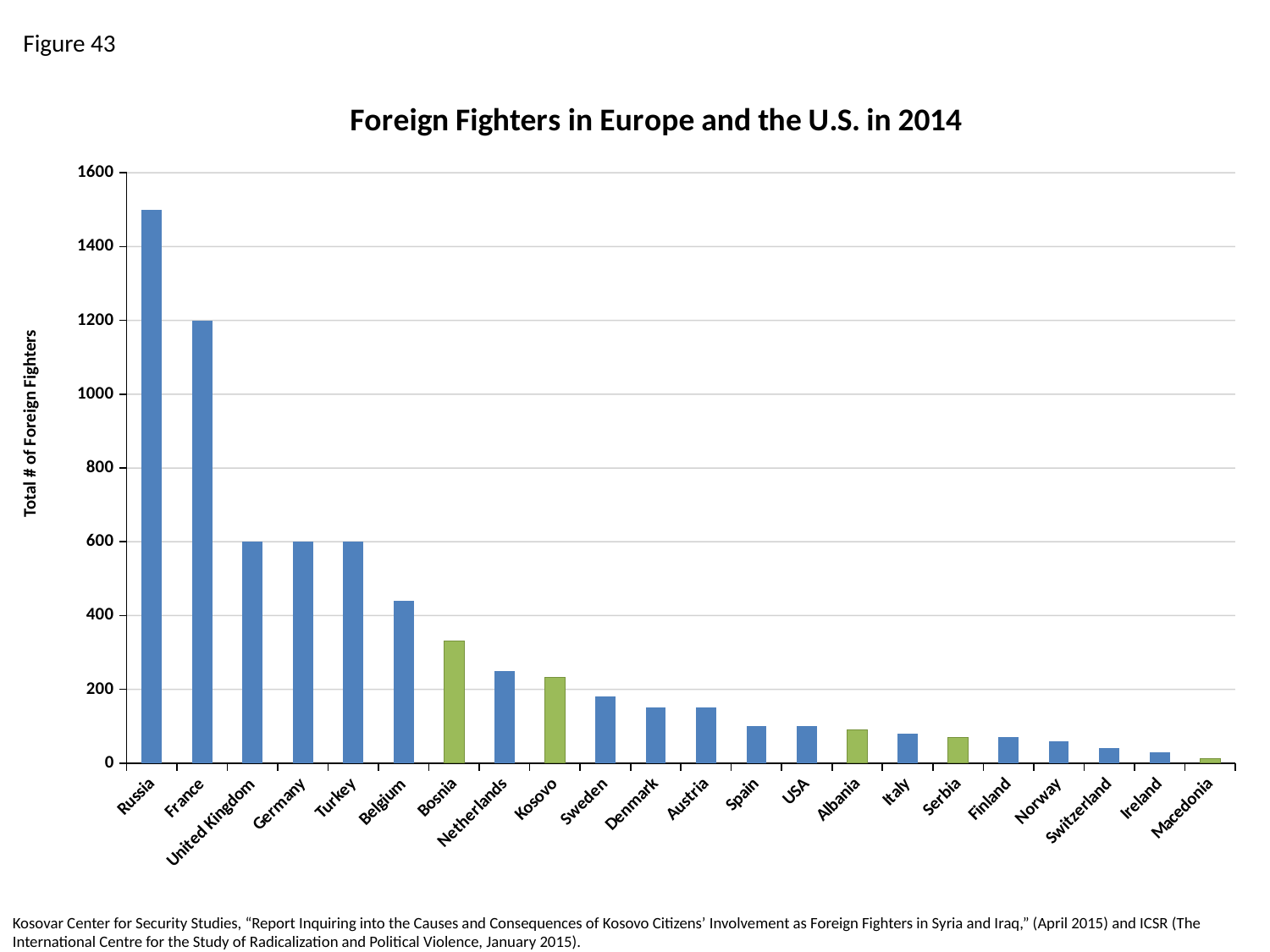
Which has a higher value, Bosnia or Netherlands? Bosnia What is the value for France? 1200 What is the label on the vertical axis? Total # of Foreign Fighters Is the value for Russia greater or less than 1400? greater What kind of chart is shown on the slide? Bar chart Is the value for Belgium greater or less than 400? greater What is the title of the chart? Foreign Fighters in Europe and the U.S. in 2014 How many countries are shown on the chart? 22 Which country has the highest number of foreign fighters? Russia Which country has the lowest number of foreign fighters? Macedonia What is the value for Germany? 600 Is the value for Sweden greater or less than 200? less